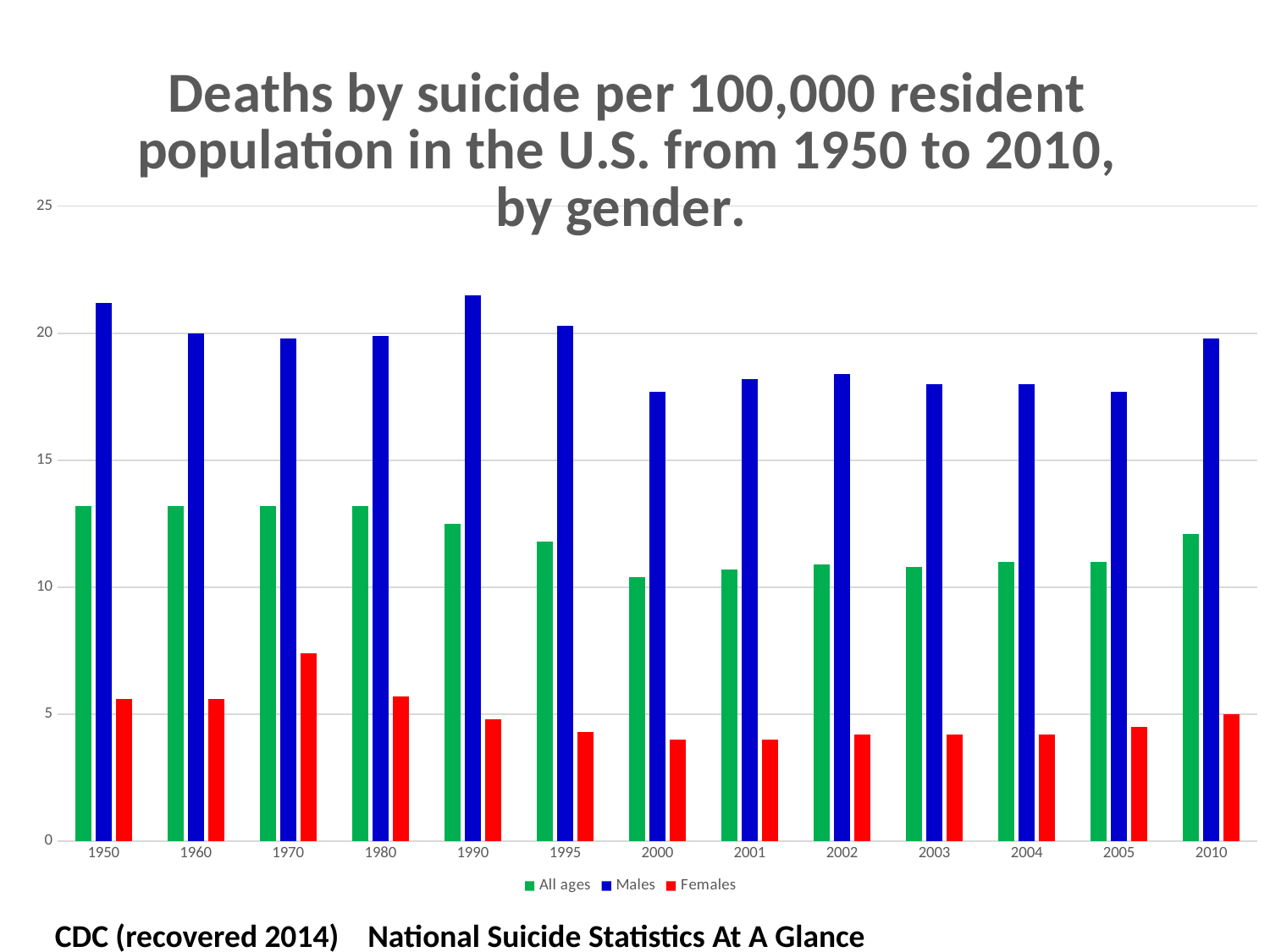
Does the All ages value generally rise or fall from 1950 to 2005? fall What kind of chart is shown on the slide? Bar chart Is the value for Males in 2005 greater or less than 20? less Is the value for Females in 2000 greater or less than 5? less Is the value for All ages in 1990 greater or less than 15? less In which year is the Females value highest? 1970 Which is larger, the Males value in 1950 or the Males value in 2000? 1950 How many years are shown along the x axis? 13 Which series is shown in red in the legend? Females How many series does the legend list? 3